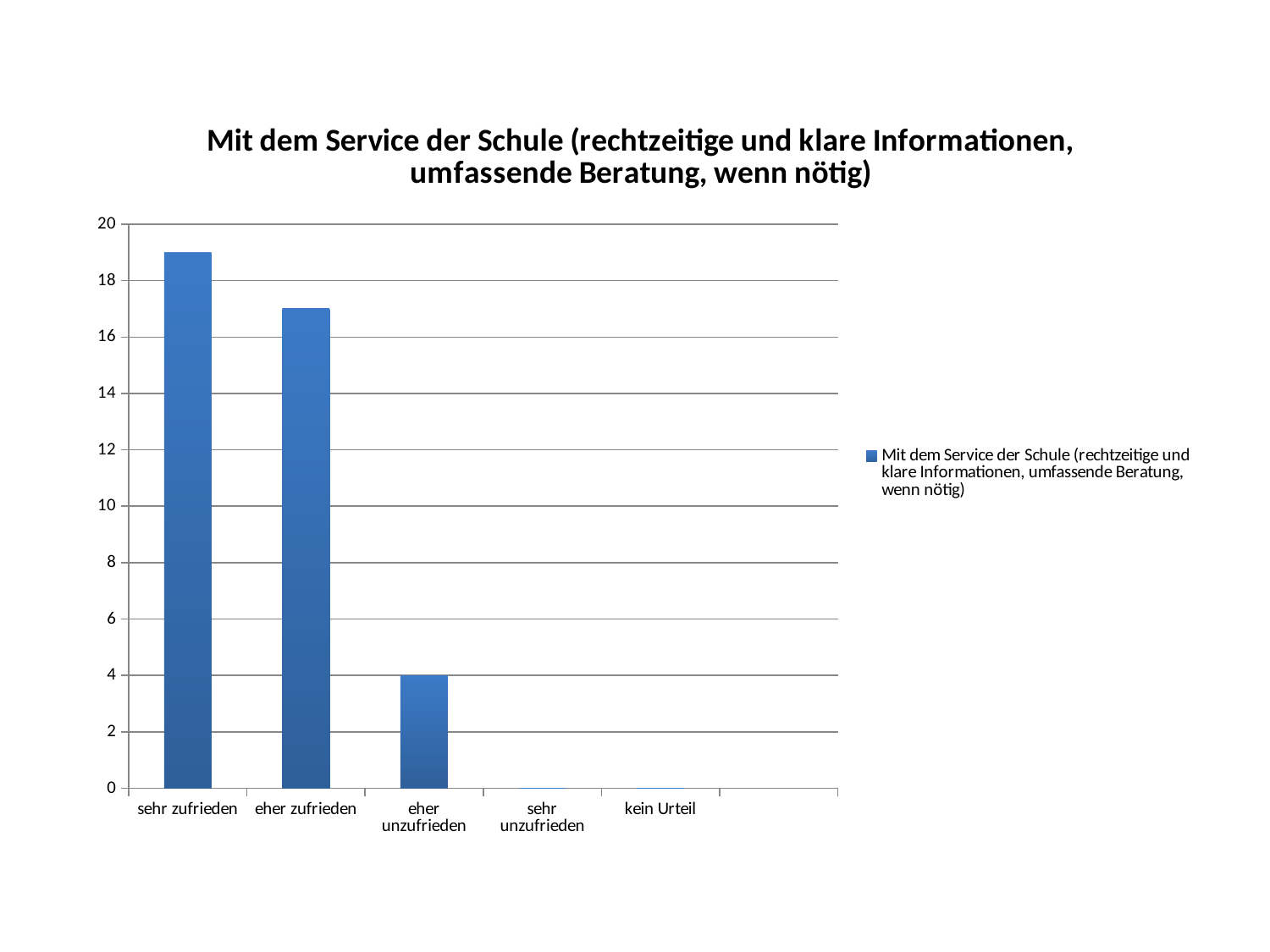
What is the value for "eher unzufrieden"? 4 Is the value for "eher zufrieden" greater or less than 16? greater How many categories are labeled on the x axis? 5 Which is larger, the value for "eher zufrieden" or the value for "eher unzufrieden"? eher zufrieden Is the value for "eher zufrieden" greater or less than 18? less How many series does the legend list? 1 Which category has the highest value? sehr zufrieden What colour are the bars in the chart? blue What kind of chart is shown on the slide? bar chart Is the value for "sehr zufrieden" greater or less than 18? greater Which is larger, the value for "sehr zufrieden" or the value for "eher zufrieden"? sehr zufrieden Do the values rise or fall from left to right along the x axis? fall